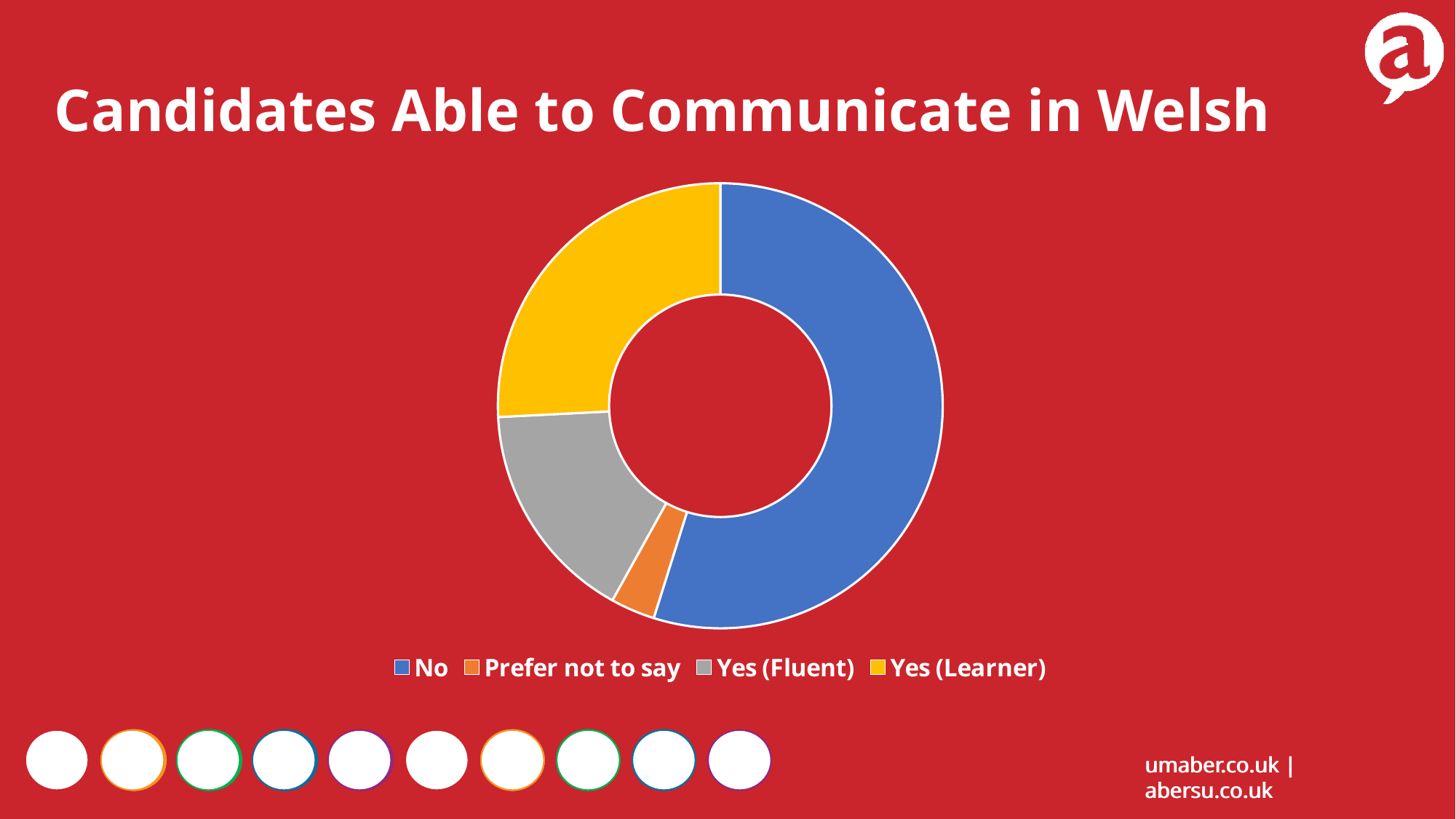
How many categories does the chart's legend list? 4 What is the title of the slide containing the chart? Candidates Able to Communicate in Welsh Which category has the largest share of the chart? No Does the No slice take up more or less than half of the chart? More Which is larger, the share for No or the share for Yes (Learner)? No What kind of chart is shown on the slide? Doughnut (pie) chart Which is larger, the share for Yes (Fluent) or the share for Prefer not to say? Yes (Fluent) What colour represents the Yes (Learner) category in the chart? Yellow Which category has the smallest share of the chart? Prefer not to say